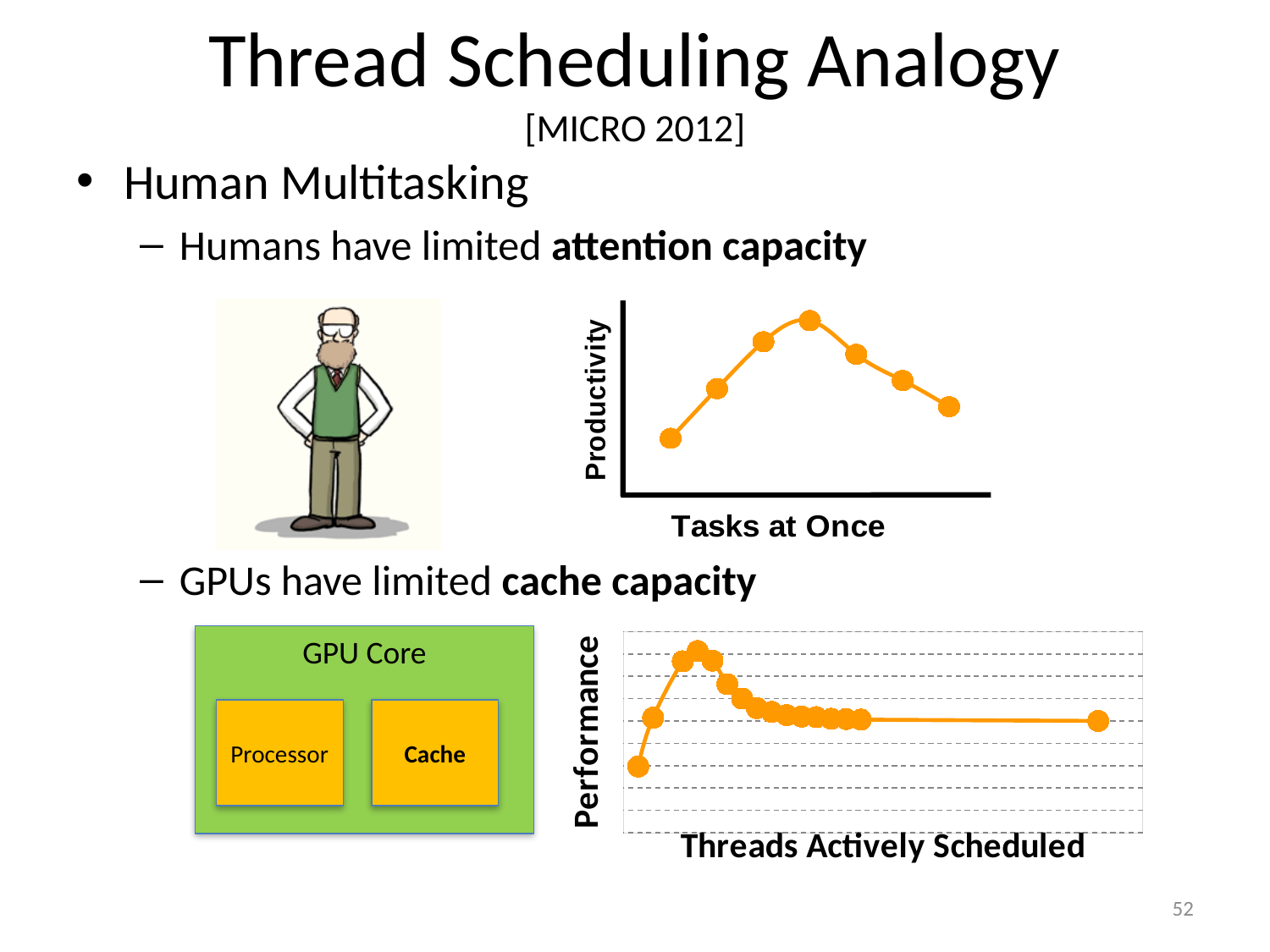
On the chart with the x axis "Tasks at Once", which is higher: the first point or the last point? the last point On the chart with the x axis "Tasks at Once", which point has the lowest productivity? the first point On the chart with the y axis "Performance", what is the x-axis label? Threads Actively Scheduled How many data points are plotted on the chart with the x axis "Tasks at Once"? 7 On the chart with the x axis "Threads Actively Scheduled", how does performance change as more threads are scheduled? rises sharply to a peak, then falls and flattens out On the chart with the x axis "Tasks at Once", how does productivity change as the number of tasks increases? rises to a peak, then falls On the chart with the x axis "Tasks at Once", which point is the highest: the first, the fourth, or the last? the fourth On the chart with the y axis "Performance", which is higher: the first point or the last point? the last point What kind of chart is the chart labelled "Threads Actively Scheduled" on the x axis? line chart On the chart with the x axis "Tasks at Once", what is the y-axis label? Productivity What kind of chart is the chart labelled "Tasks at Once" on the x axis? line chart On the chart with the y axis "Performance", which point has the lowest performance? the first point